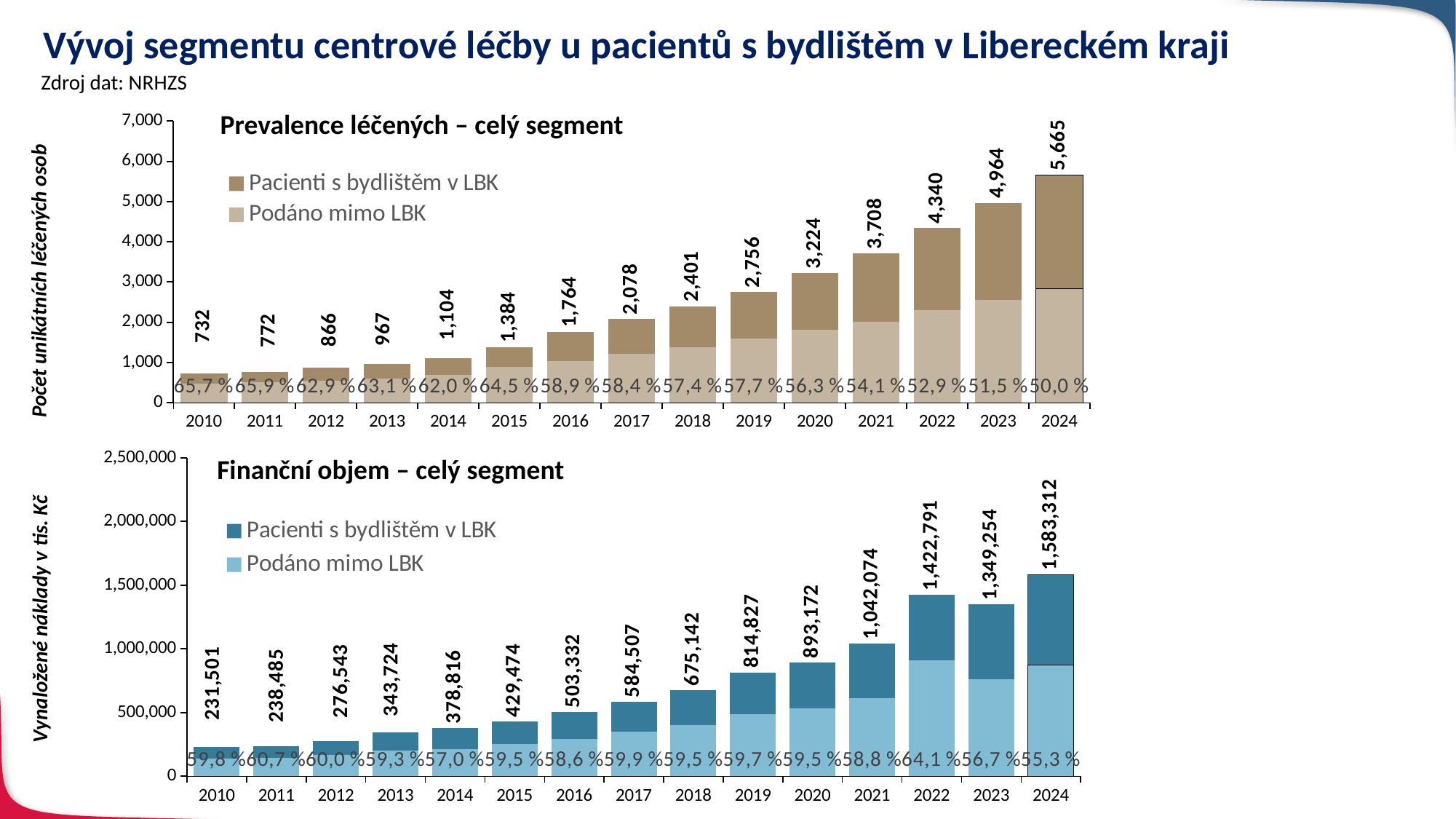
In the 'Finanční objem – celý segment' chart, which year has the highest total? 2024 In the 'Prevalence léčených – celý segment' chart, what is the difference between the totals for 2024 and 2023? 701 How many series does the legend of the 'Finanční objem – celý segment' chart list? 2 In the 'Finanční objem – celý segment' chart, what is the total value labelled for 2022? 1,422,791 In the 'Finanční objem – celý segment' chart, which total is larger: 2022 or 2023? 2022 How many years are shown on the x axis of the 'Prevalence léčených – celý segment' chart? 15 In the 'Prevalence léčených – celý segment' chart, what is the total value labelled for 2010? 732 In the 'Prevalence léčených – celý segment' chart, which year has the lowest total? 2010 In the 'Prevalence léčených – celý segment' chart, what is the total value labelled for 2024? 5,665 In the 'Finanční objem – celý segment' chart, is the total for 2021 greater or less than 1,000,000? greater What kind of chart is the 'Finanční objem – celý segment' chart? Stacked bar chart In the 'Prevalence léčených – celý segment' chart, what percentage is shown at the bottom of the 2024 bar? 50,0 %